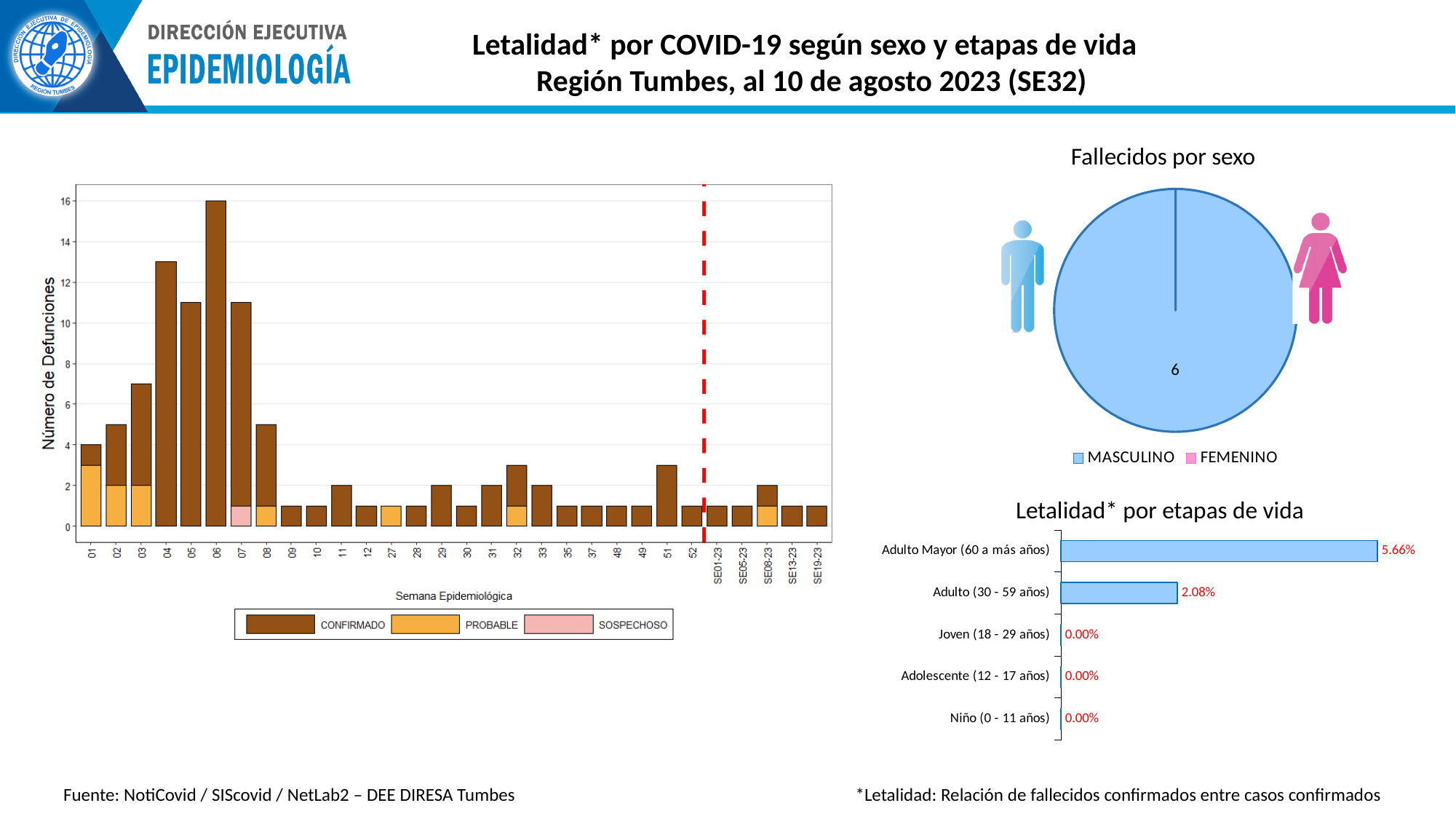
In the 'Letalidad* por etapas de vida' chart, what is the difference between the values for Adulto Mayor and Adulto? 3.58% In the 'Fallecidos por sexo' pie chart, what value is shown for MASCULINO? 6 In the 'Letalidad* por etapas de vida' chart, how many age groups are shown? 5 In the 'Letalidad* por etapas de vida' chart, what is the value for Adulto (30 - 59 años)? 2.08% In the 'Letalidad* por etapas de vida' chart, what is the value for Joven (18 - 29 años)? 0.00% What kind of chart is 'Fallecidos por sexo'? Pie chart In the left chart of deaths by epidemiological week, is the value for week 04 greater or less than 12? greater How many entries does the legend of the 'Fallecidos por sexo' pie chart list? 2 How many series does the legend of the left chart of deaths by epidemiological week list? 3 In the 'Letalidad* por etapas de vida' chart, what is the value for Adulto Mayor (60 a más años)? 5.66% In the left chart of deaths by epidemiological week, which week has the highest number of deaths? 06 In the 'Letalidad* por etapas de vida' chart, which age group has the highest lethality? Adulto Mayor (60 a más años)